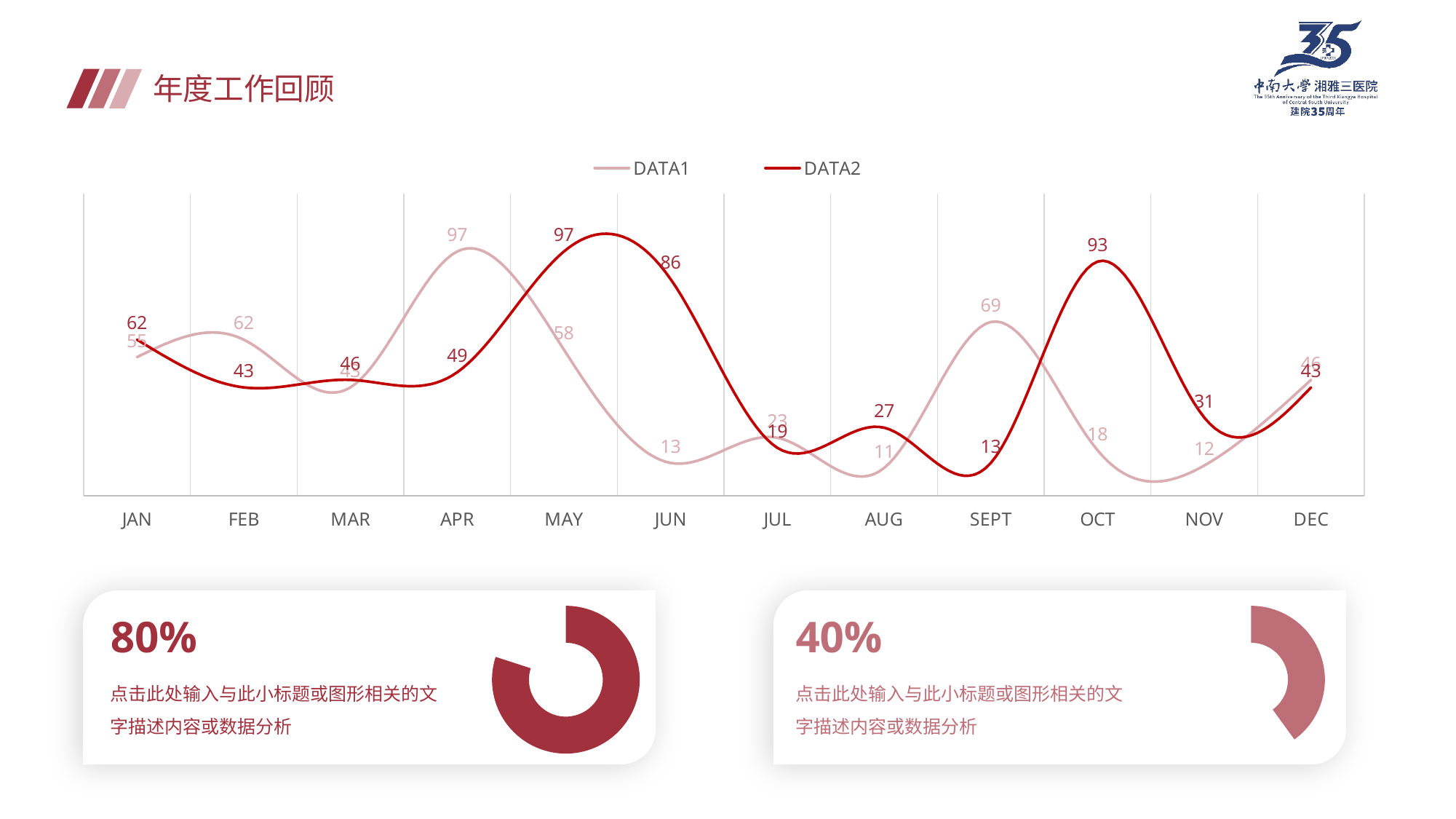
In which month does DATA2 reach its highest value? MAY What kind of chart is shown on the slide? Line chart Does DATA2 rise or fall from SEPT to OCT? Rise How many series does the chart legend list? 2 What is the value of DATA1 in APR? 97 In JUN, which series has the larger value, DATA1 or DATA2? DATA2 In which month does DATA2 have its lowest value? SEPT What is the difference between the DATA2 value in MAY and the DATA2 value in JUL? 78 What are the names of the two series in the chart legend? DATA1 and DATA2 How many months are plotted along the x axis of the chart? 12 What is the value of DATA2 in OCT? 93 What is the value of DATA1 in SEPT? 69